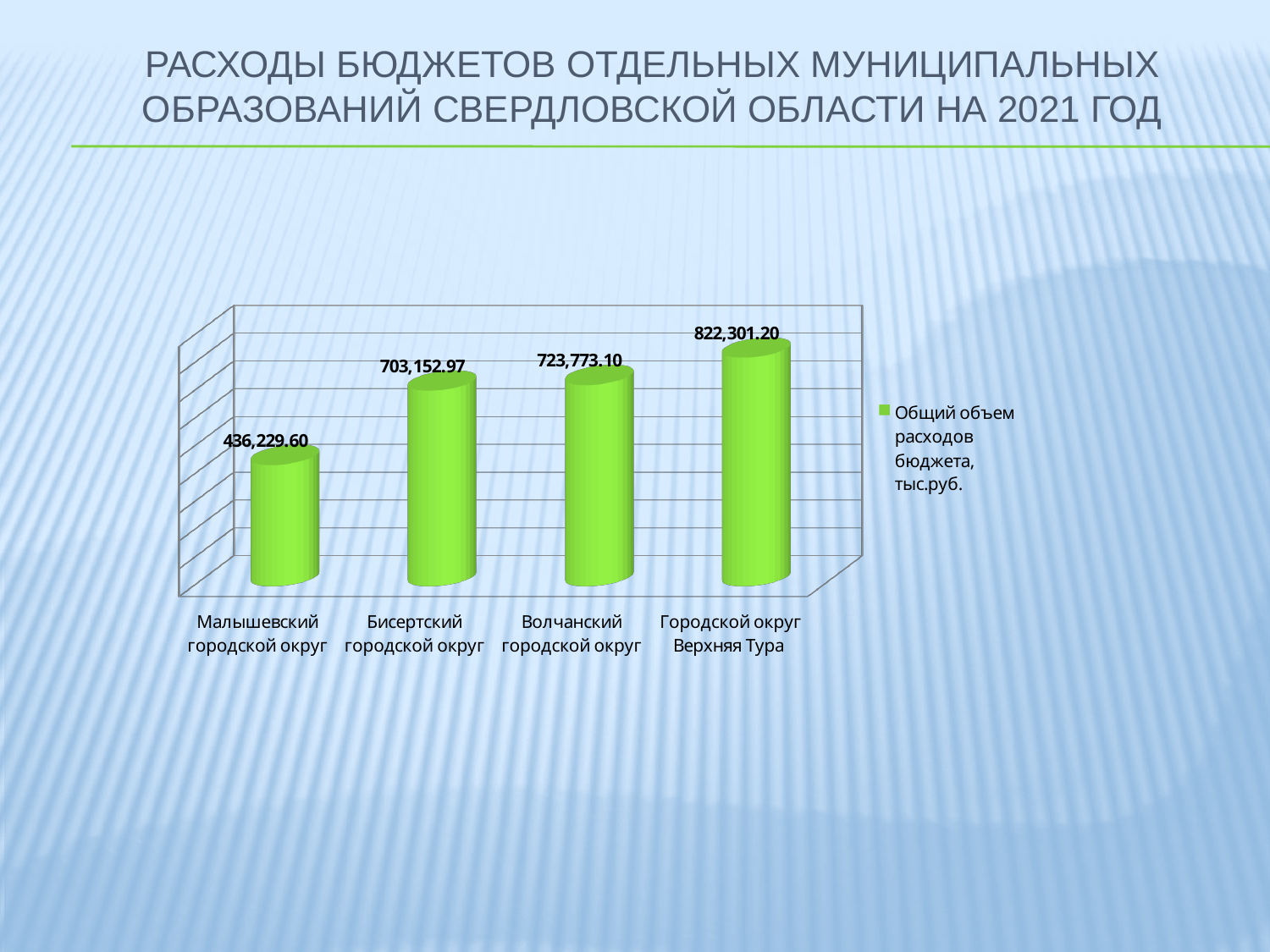
What is the value for Волчанский городской округ? 723,773.10 Which municipality has the lowest budget expenditure? Малышевский городской округ How many municipalities are shown in the chart? 4 What kind of chart is shown on the slide? Bar chart What is the value for Бисертский городской округ? 703,152.97 Which municipality has the highest budget expenditure? Городской округ Верхняя Тура Which is larger, the value for Волчанский городской округ or Бисертский городской округ? Волчанский городской округ What is the difference between the values for Волчанский городской округ and Бисертский городской округ? 20,620.13 Do the values rise or fall from left to right across the categories? Rise What is the value for Малышевский городской округ? 436,229.60 What is the difference between the values for Городской округ Верхняя Тура and Малышевский городской округ? 386,071.60 What is the value for Городской округ Верхняя Тура? 822,301.20